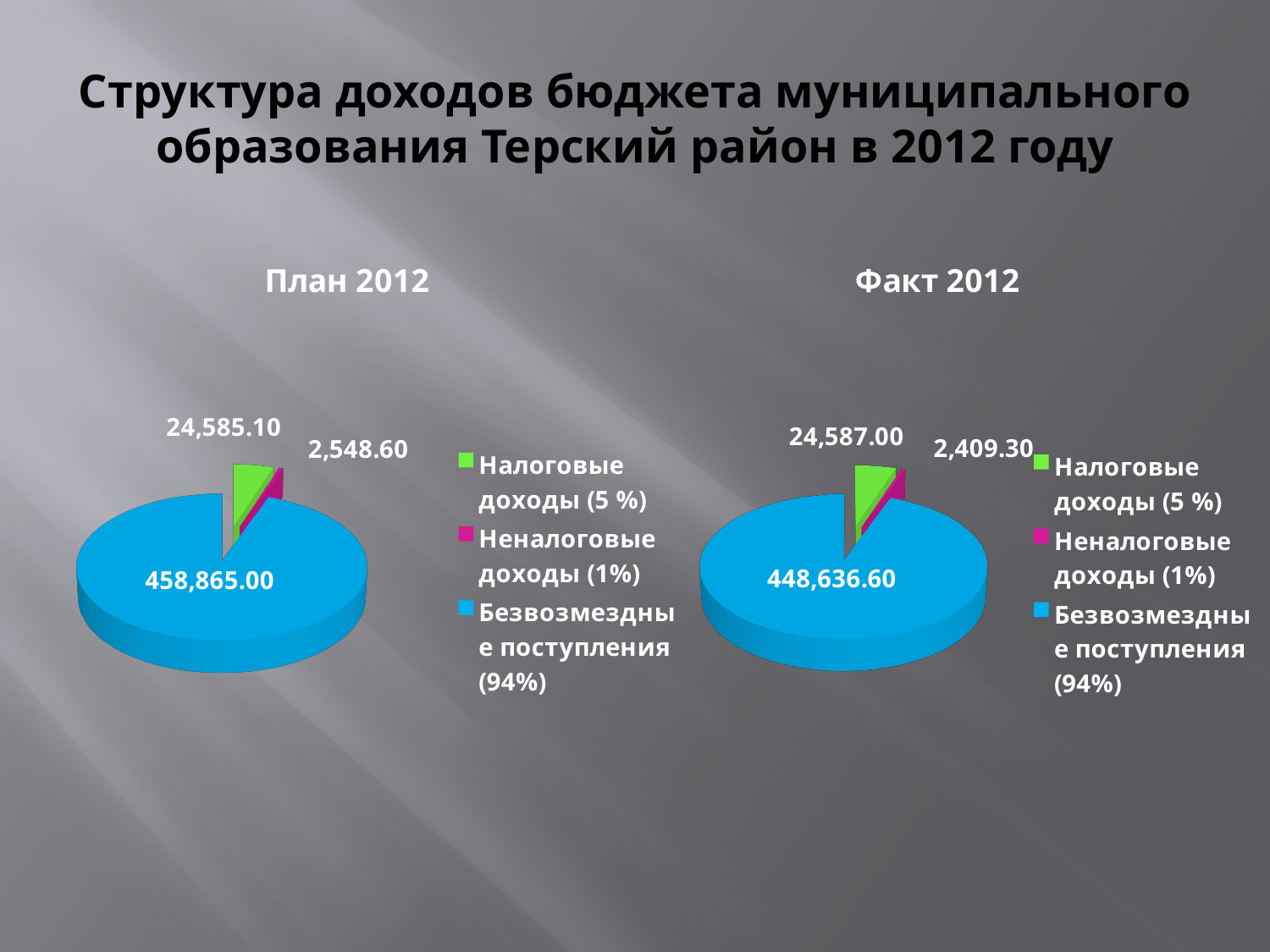
What is the difference between Безвозмездные поступления in the "План 2012" chart and in the "Факт 2012" chart? 10,228.40 In the "План 2012" chart, what is the difference between Налоговые доходы and Неналоговые доходы? 22,036.50 In the "План 2012" chart, what is the value for Безвозмездные поступления? 458,865.00 In the "Факт 2012" chart, what is the value for Неналоговые доходы? 2,409.30 Which is larger: Безвозмездные поступления in the "План 2012" chart or in the "Факт 2012" chart? План 2012 According to the legend of the "Факт 2012" chart, what share of the pie is Безвозмездные поступления? 94% In the "Факт 2012" chart, which category has the smallest slice? Неналоговые доходы In the "План 2012" chart, which category has the largest slice? Безвозмездные поступления What colour is the Неналоговые доходы slice in the "План 2012" chart? Magenta (pink) How many categories does the "Факт 2012" chart show? 3 What kind of chart is the "План 2012" chart? Pie chart In the "Факт 2012" chart, what is the value for Налоговые доходы? 24,587.00